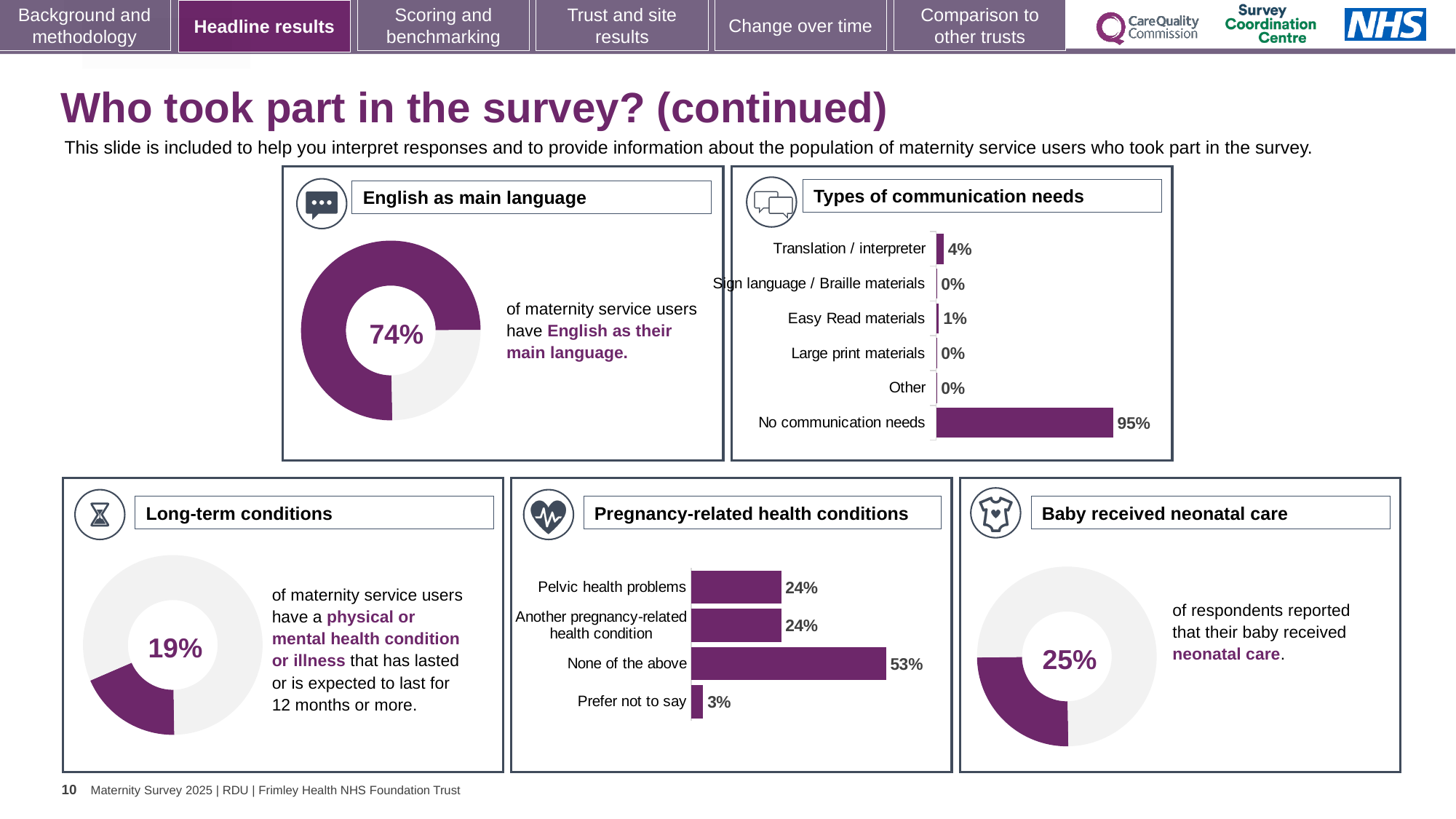
In the 'Types of communication needs' chart, how many categories are shown? 6 Which is larger: the 'Long-term conditions' donut value or the 'Baby received neonatal care' donut value? Baby received neonatal care In the 'Pregnancy-related health conditions' chart, what kind of chart is used? Bar chart In the 'Types of communication needs' chart, which category has the highest value? No communication needs In the 'Baby received neonatal care' chart, what percentage of respondents reported that their baby received neonatal care? 25% In the 'Pregnancy-related health conditions' chart, what is the difference between 'None of the above' and 'Pelvic health problems'? 29% In the 'Pregnancy-related health conditions' chart, which category has the lowest value? Prefer not to say In the 'Types of communication needs' chart, what is the value for 'Translation / interpreter'? 4% In the 'Pregnancy-related health conditions' chart, what is the value for 'None of the above'? 53% In the 'English as main language' chart, what percentage of maternity service users have English as their main language? 74% In the 'Types of communication needs' chart, what is the difference between 'No communication needs' and 'Translation / interpreter'? 91% In the 'Long-term conditions' chart, what percentage of maternity service users have a physical or mental health condition or illness lasting 12 months or more? 19%